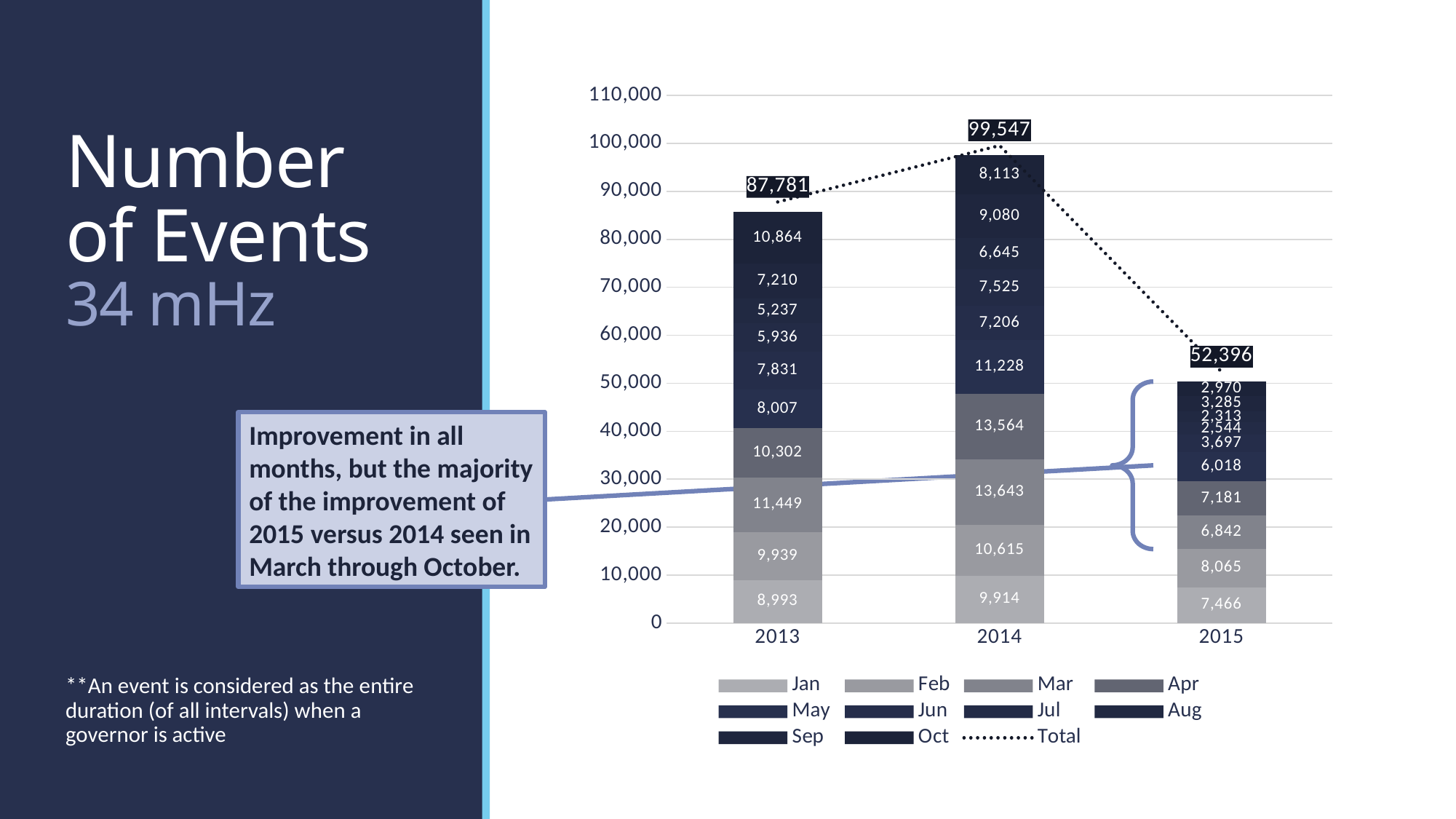
What is the Total value shown for 2013? 87,781 Which year has the highest Total number of events? 2014 What is the Total value shown for 2014? 99,547 What is the value of the Oct segment (top of the stack) for 2013? 10,864 Is the Jan segment larger in 2014 or in 2015? 2014 What is the value of the Jan segment (bottom of the stack) for 2015? 7,466 How many series does the legend list? 11 Which year has the lowest Total number of events? 2015 What is the difference between the Total values for 2014 and 2013? 11,766 What is the Total value shown for 2015? 52,396 How many years are shown on the x axis? 3 What is the difference between the Total values for 2014 and 2015? 47,151